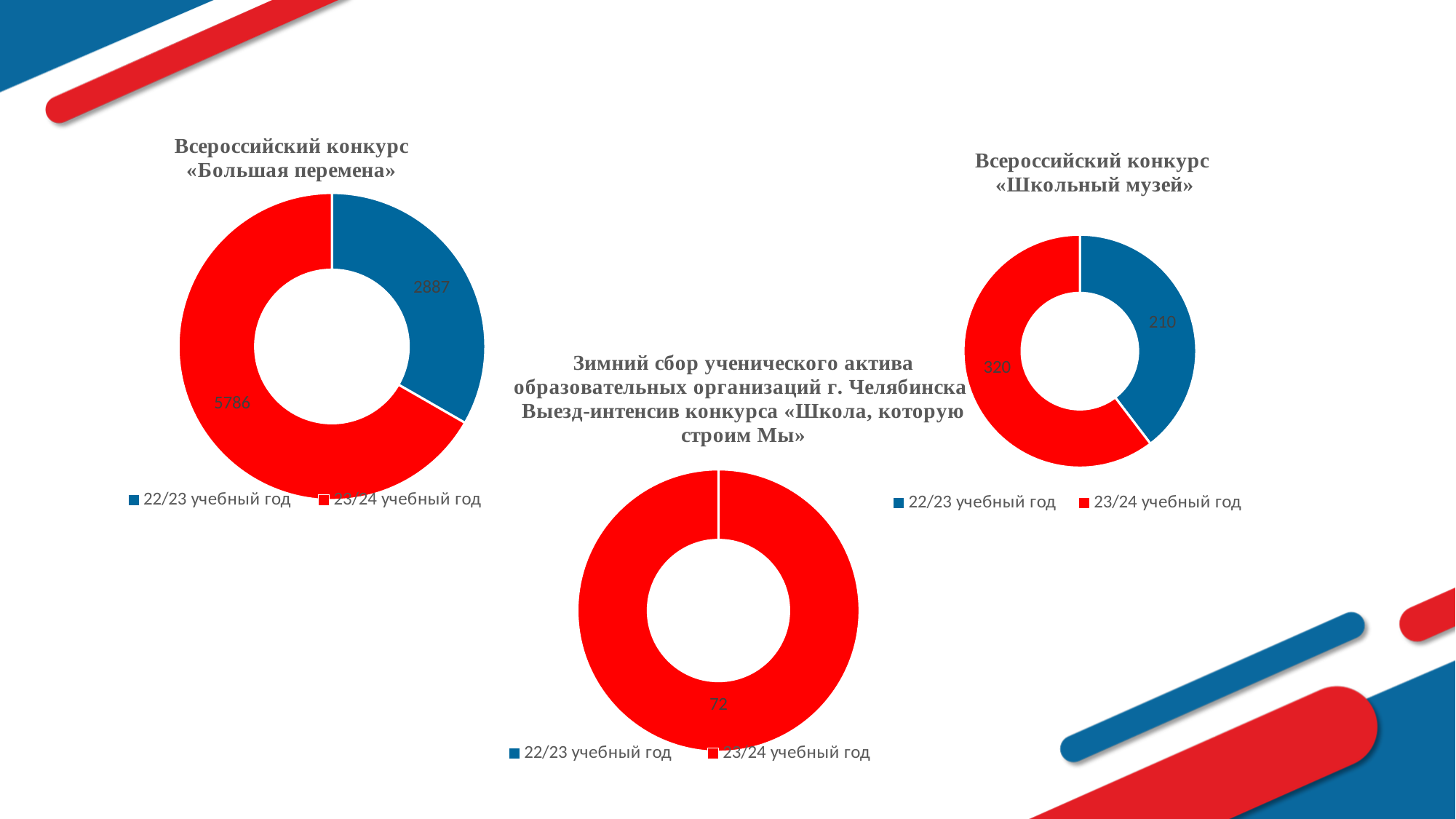
In the chart titled «Школьный музей», which series has the largest slice? 23/24 учебный год In the chart titled «Школьный музей», what is the value for 22/23 учебный год? 210 In the chart titled «Школьный музей», what is the value for 23/24 учебный год? 320 What type of chart is used for «Большая перемена»? Doughnut chart In the chart titled «Большая перемена», what is the total of the two values shown? 8673 In the chart titled «Большая перемена», which year has the larger value, 22/23 or 23/24? 23/24 учебный год In the chart titled «Зимний сбор ученического актива...», what value is shown for 23/24 учебный год? 72 In the chart titled «Большая перемена», what is the value for 22/23 учебный год? 2887 In the chart titled «Школьный музей», what is the difference between the 23/24 and 22/23 values? 110 In the chart titled «Большая перемена», what is the value for 23/24 учебный год? 5786 How many series does the legend of the chart titled «Школьный музей» list? 2 In the chart titled «Большая перемена», what is the difference between the 23/24 and 22/23 values? 2899